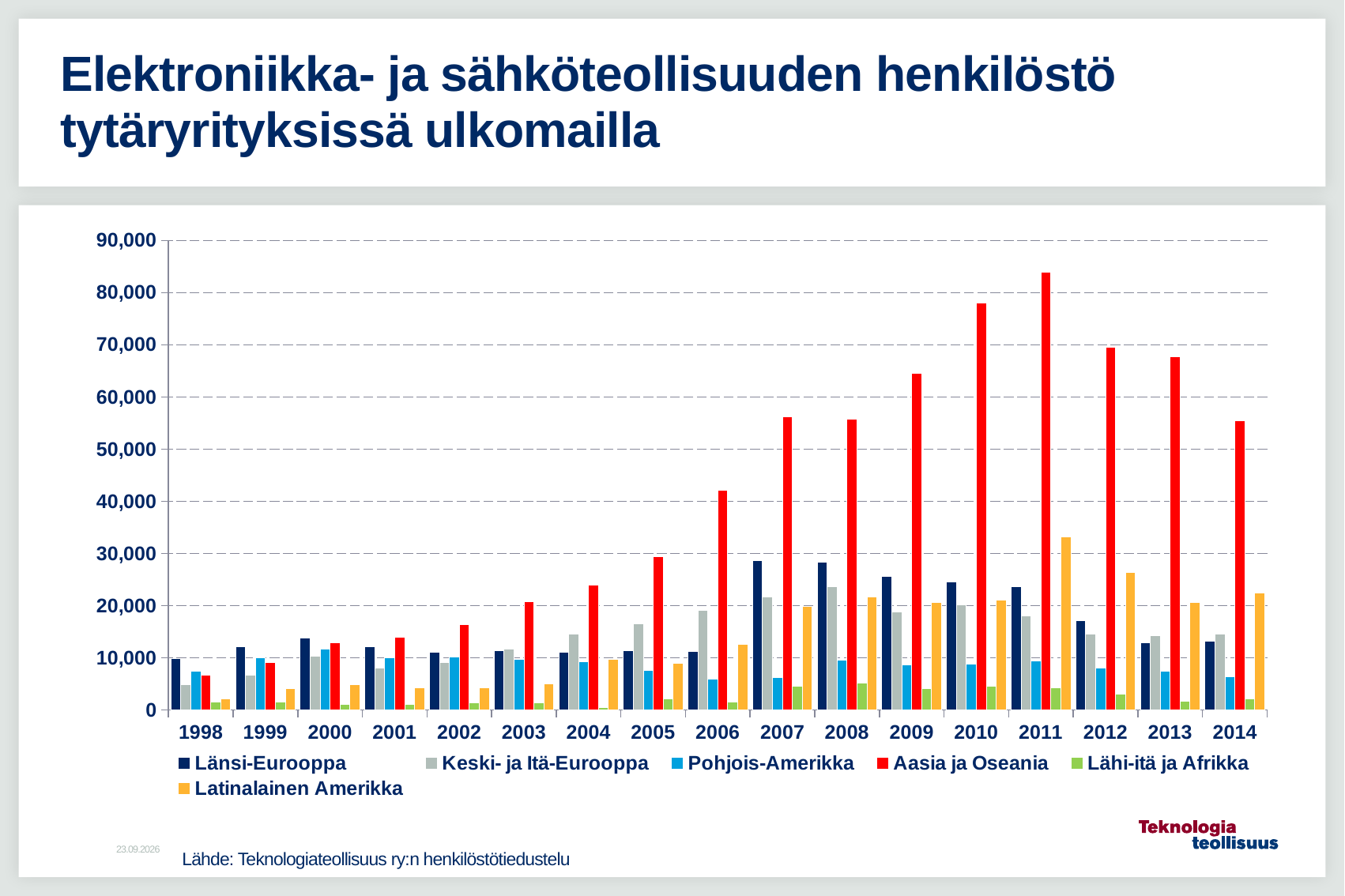
Is the value for Pohjois-Amerikka in 2014 greater or less than 10,000? less What colour represents Aasia ja Oseania in the chart? red What kind of chart is shown on the slide? bar chart Is the value for Aasia ja Oseania in 2010 greater or less than 70,000? greater How many series does the legend list? 6 In which year is the value for Aasia ja Oseania lowest? 1998 Does the value for Aasia ja Oseania rise or fall from 1998 to 2011? rise In which year is the value for Aasia ja Oseania highest? 2011 How many years are shown on the x axis? 17 In which year is the value for Latinalainen Amerikka highest? 2011 Is the value for Aasia ja Oseania in 2011 greater or less than 80,000? greater Which is larger, the value for Aasia ja Oseania in 2010 or in 2012? 2010